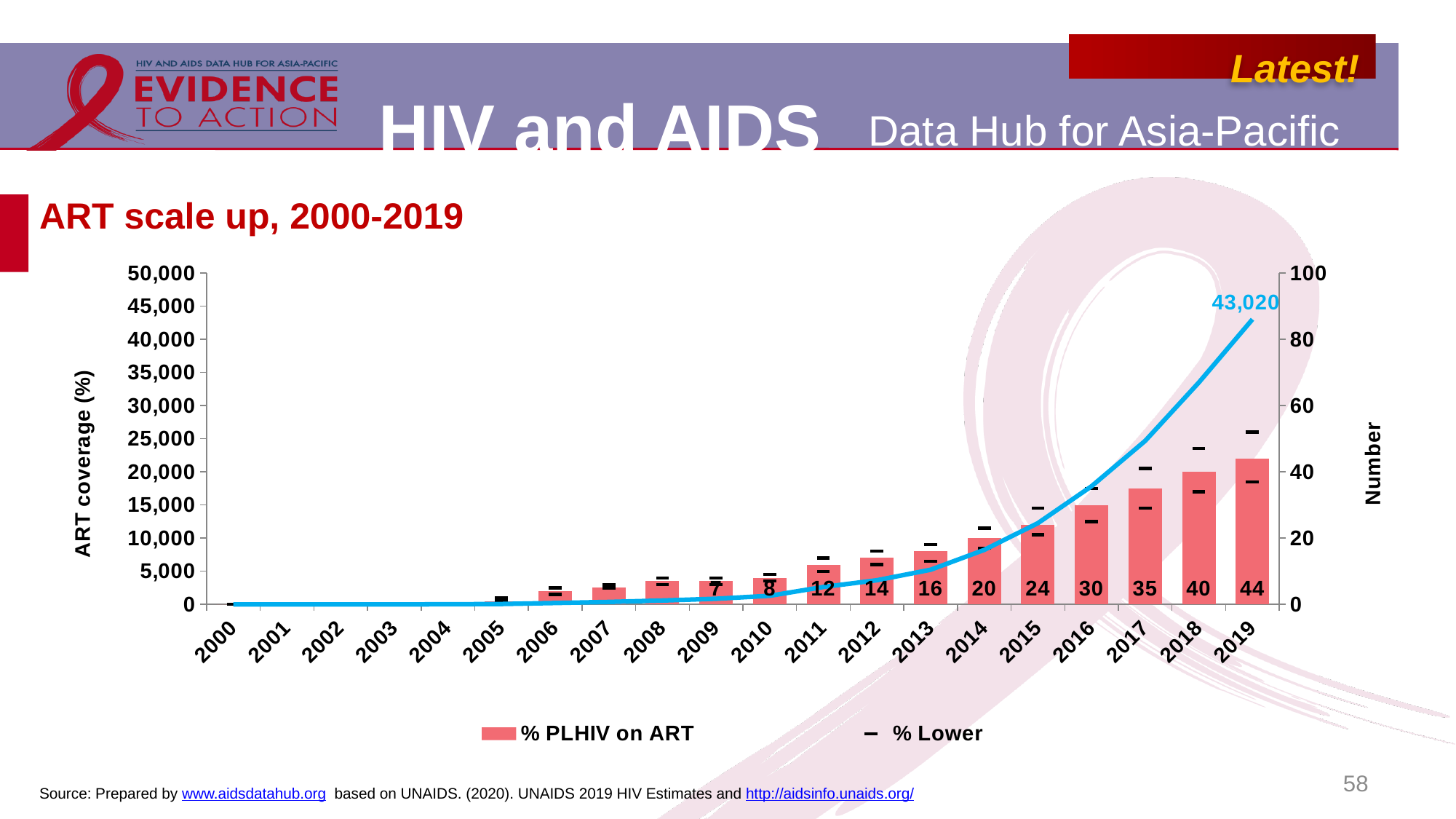
What is the % PLHIV on ART value shown for 2019? 44 How many series does the legend list? 2 What is the difference in % PLHIV on ART between 2019 and 2014? 24 What is the % PLHIV on ART value shown for 2014? 20 Which year has a larger % PLHIV on ART, 2016 or 2013? 2016 What is the % PLHIV on ART value shown for 2009? 7 What value is labelled on the blue line at 2019? 43,020 Which year has the highest % PLHIV on ART? 2019 Do the % PLHIV on ART values rise or fall from 2009 to 2019? Rise What kind of chart is shown on the slide? Bar and line chart How many years are shown on the x axis? 20 What is the difference in % PLHIV on ART between 2018 and 2017? 5